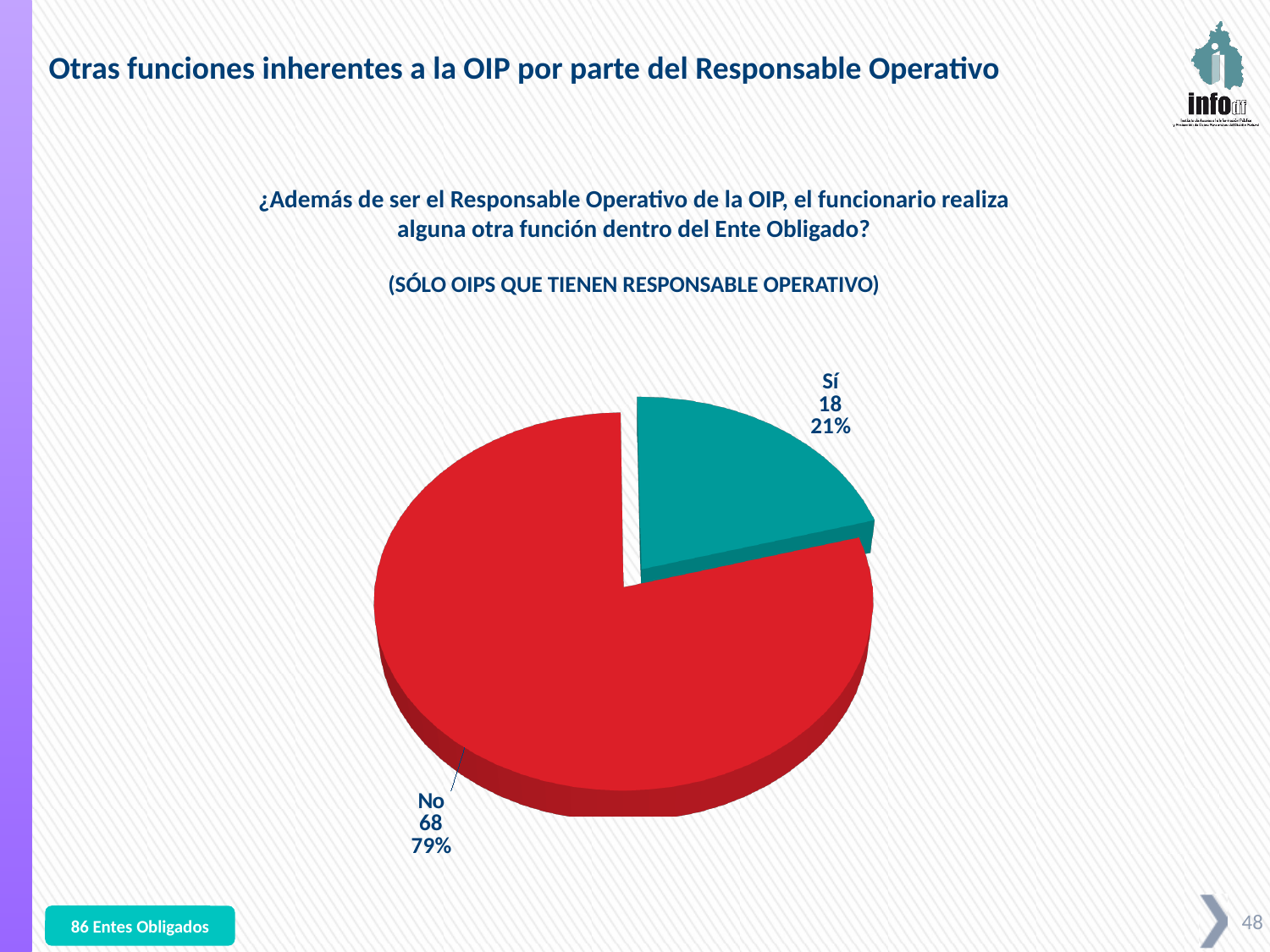
Which slice is the smallest? Sí What is the count for the "No" slice? 68 What percentage share does the "Sí" slice represent? 21% What percentage share does the "No" slice represent? 79% How many slices does the pie chart have? 2 What colour is the "Sí" slice? teal What is the count for the "Sí" slice? 18 What is the total of the two slice counts? 86 What kind of chart is shown on the slide? pie chart Which is larger, the count for "Sí" or the count for "No"? No Which slice is the largest? No What is the difference between the counts for "No" and "Sí"? 50